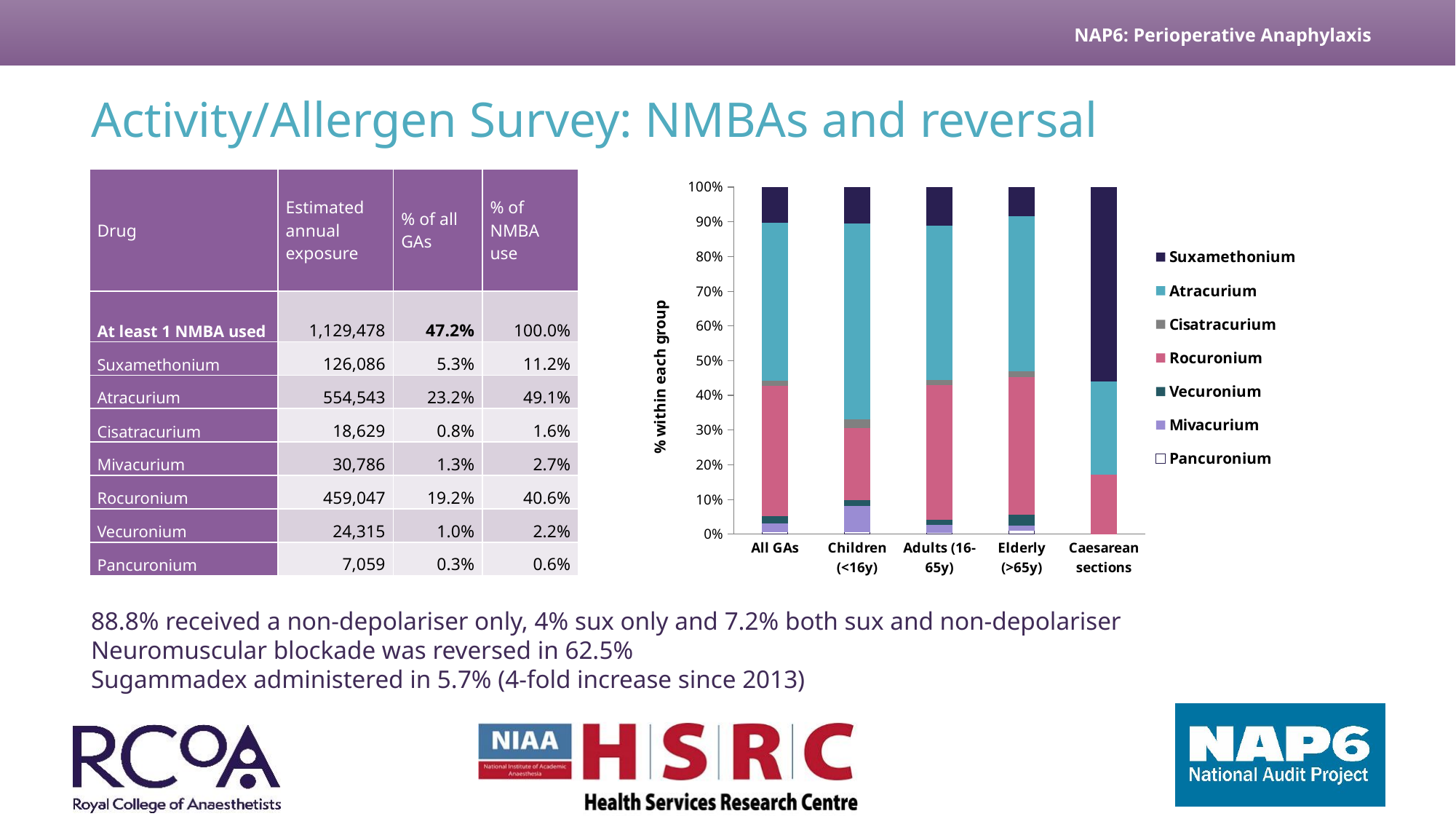
Which group has the largest Mivacurium share in the chart? Children (<16y) What is the title of the chart's y axis? % within each group Which group has the larger Suxamethonium share, All GAs or Caesarean sections? Caesarean sections Is the Rocuronium share for Caesarean sections greater or less than 20%? less What kind of chart is shown on the slide? Stacked bar chart Is the Mivacurium share for Children (<16y) greater or less than 10%? less Is the Suxamethonium share for Caesarean sections greater or less than 50%? greater How many series does the chart legend list? 7 How many patient groups are shown along the x axis of the chart? 5 Which group has the largest Suxamethonium share in the chart? Caesarean sections Which group has the larger Rocuronium share, Children (<16y) or Elderly (>65y)? Elderly (>65y)